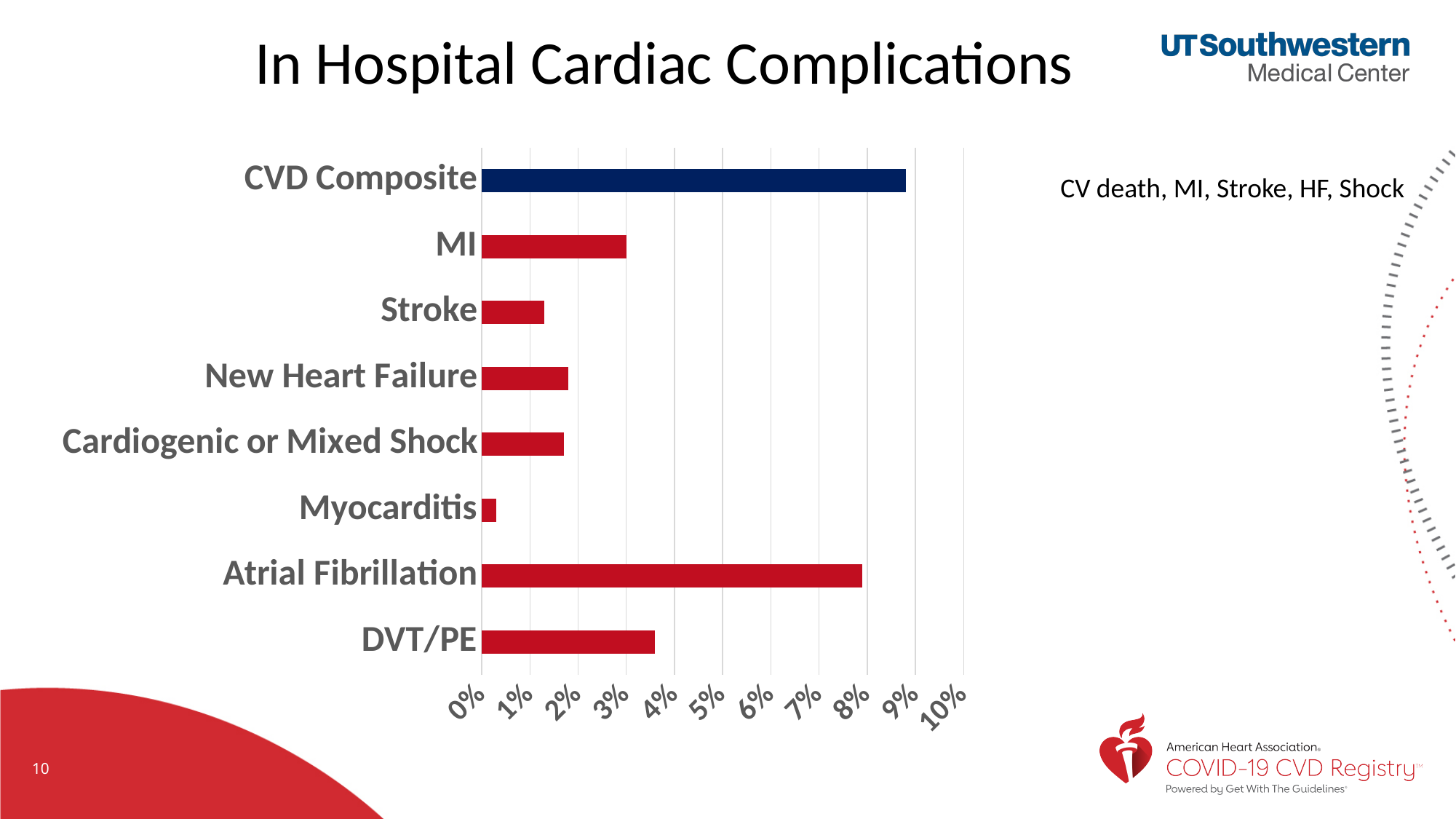
Which is larger, the value for DVT/PE or the value for Stroke? DVT/PE Which category has the lowest value in the chart? Myocarditis Is the value for Atrial Fibrillation greater or less than 9%? less Is the value for Stroke greater or less than 2%? less How many categories are plotted in the chart? 8 Is the value for Myocarditis greater or less than 1%? less Which category has the highest value in the chart? CVD Composite Which is larger, the value for Atrial Fibrillation or the value for MI? Atrial Fibrillation What is the maximum value shown on the chart's percentage axis? 10% What kind of chart is shown on the slide? bar chart What is the title of the slide containing the chart? In Hospital Cardiac Complications